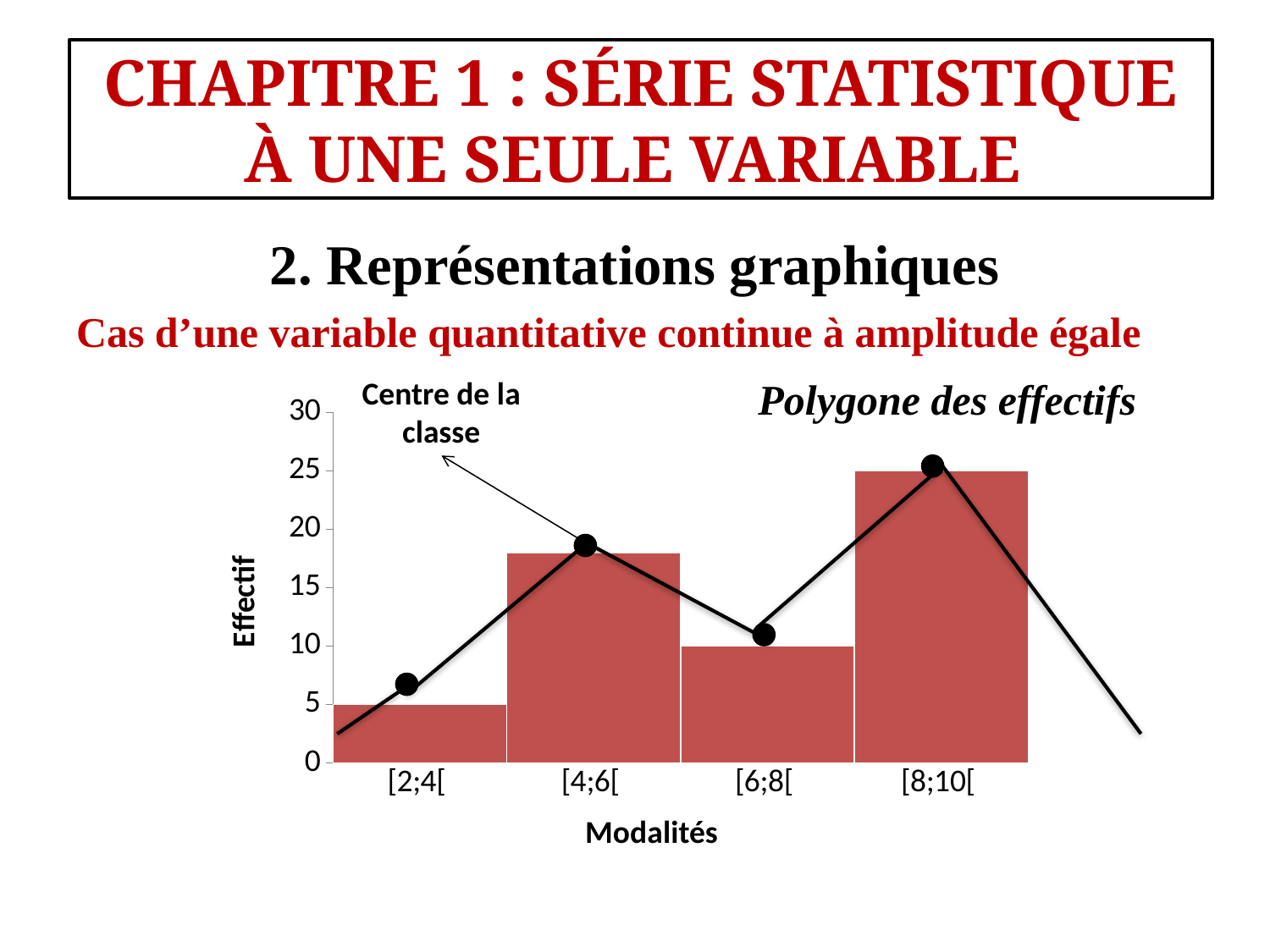
Which is larger, the value for [6;8[ or the value for [2;4[? [6;8[ Is the value for [4;6[ greater or less than 15? greater What is the title of the vertical axis? Effectif What kind of chart is this? bar chart What is the value for the [6;8[ class? 10 Which class has the lowest value? [2;4[ Which class has the highest value? [8;10[ What is the difference between the values for [8;10[ and [6;8[? 15 How many classes are shown on the x axis? 4 What is the value for the [8;10[ class? 25 What is the value for the [2;4[ class? 5 What is the difference between the values for [8;10[ and [2;4[? 20